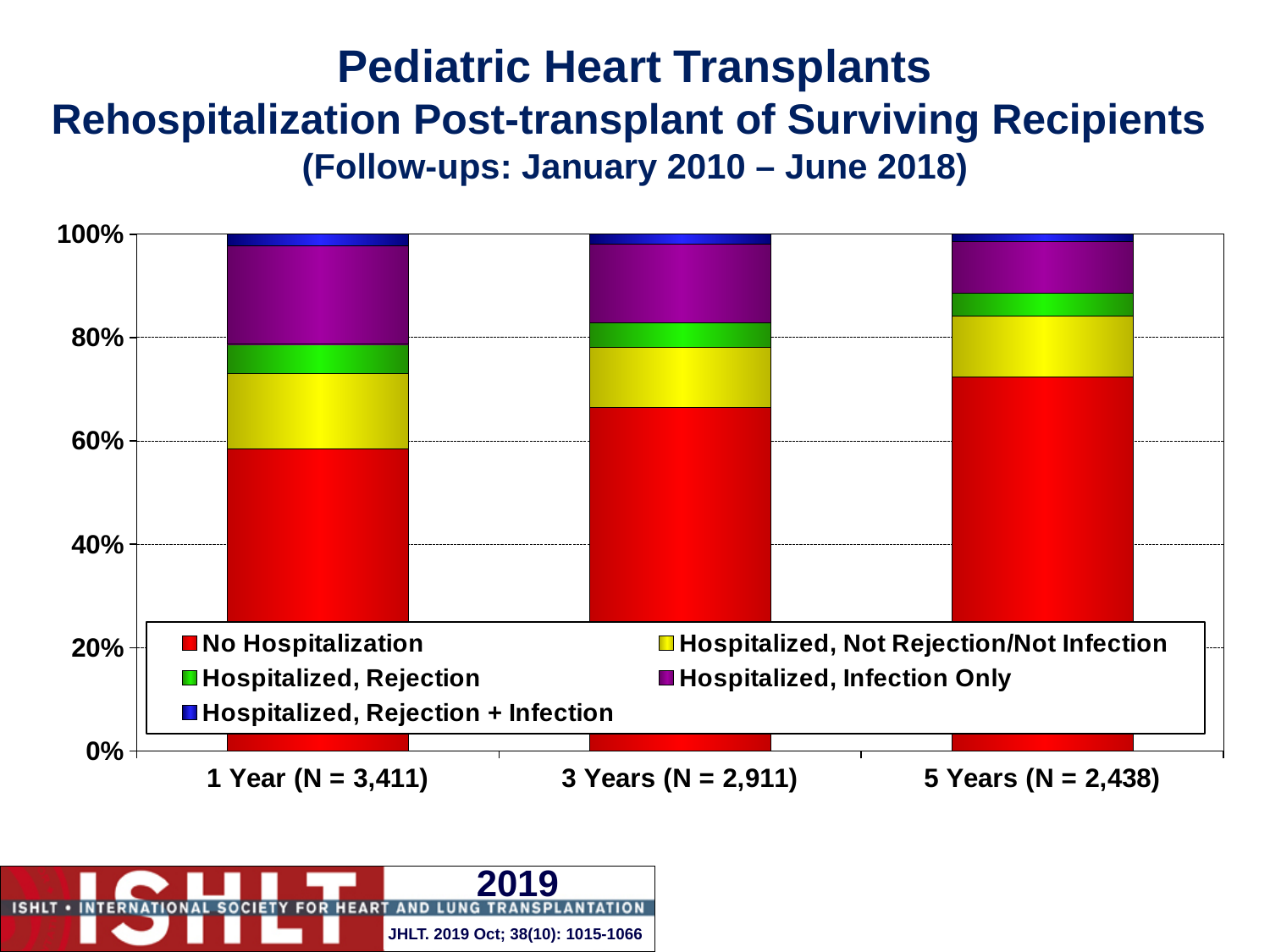
Does the No Hospitalization share rise or fall from 1 Year to 5 Years? rise At which follow-up time point is the No Hospitalization share highest? 5 Years (N = 2,438) Which has the larger Hospitalized, Infection Only share: 1 Year or 5 Years? 1 Year How many follow-up time points (categories) are shown on the x axis? 3 How many series does the legend list? 5 Is the No Hospitalization share at 3 Years greater or less than 60%? greater What is the N shown for the 1 Year category? 3,411 Is the No Hospitalization share at 1 Year greater or less than 60%? less Is the No Hospitalization share at 5 Years greater or less than 60%? greater What kind of chart is shown on the slide? Stacked bar chart What colour represents No Hospitalization in the chart? Red What does each stacked bar total? 100%